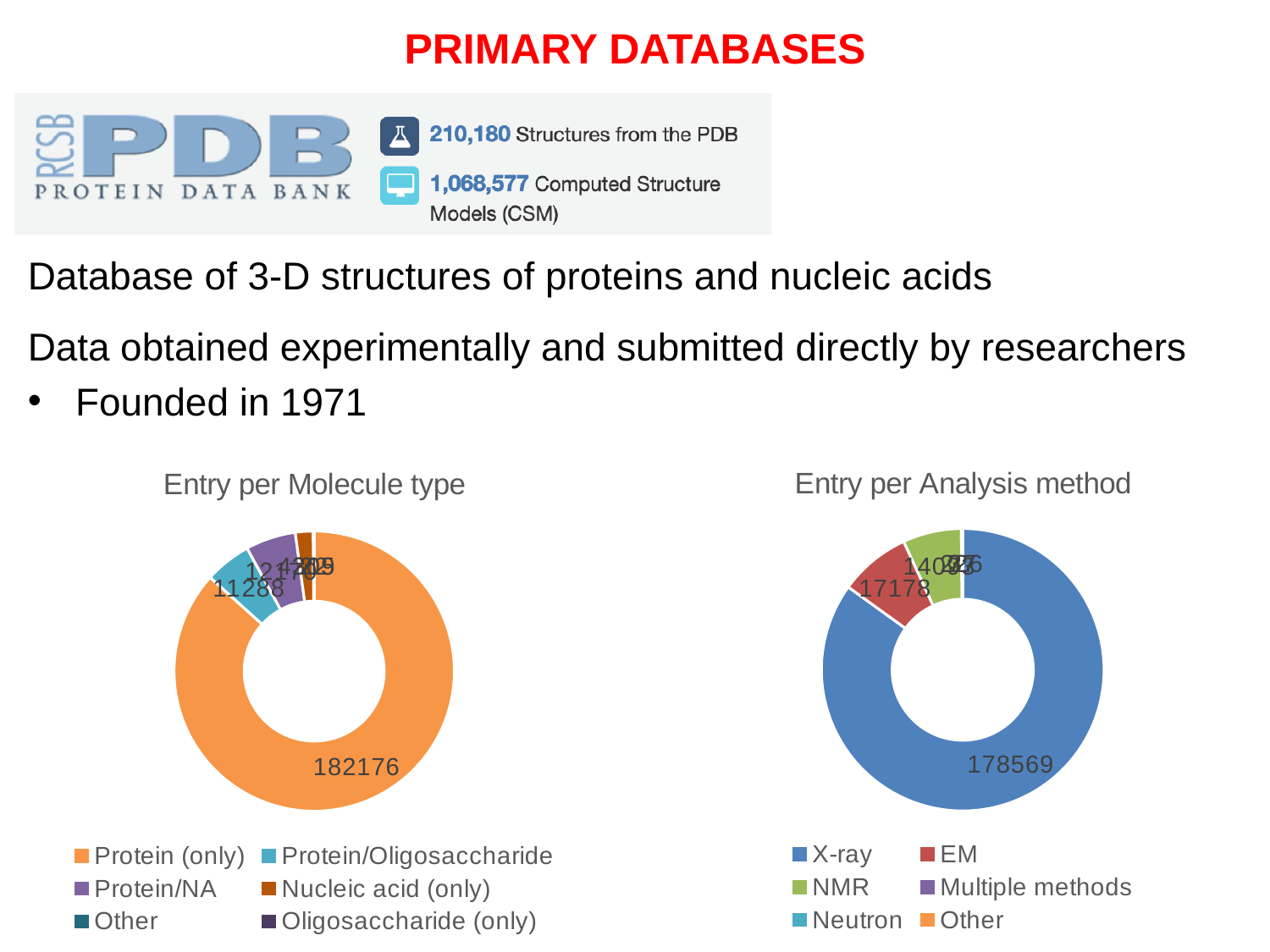
In the 'Entry per Molecule type' chart, what is the value for Protein/Oligosaccharide? 11288 In the 'Entry per Analysis method' chart, what is the difference between X-ray and EM? 161391 In the 'Entry per Analysis method' chart, what colour represents X-ray? Blue In the 'Entry per Analysis method' chart, what is the value for EM? 17178 In the 'Entry per Molecule type' chart, what is the difference between Protein (only) and Protein/Oligosaccharide? 170888 In the 'Entry per Molecule type' chart, which category has the largest share? Protein (only) In the 'Entry per Molecule type' chart, what is the value for Protein (only)? 182176 In the 'Entry per Analysis method' chart, which method has the largest share? X-ray In the 'Entry per Molecule type' chart, what kind of chart is shown? Doughnut (pie) chart In the 'Entry per Analysis method' chart, which is larger, EM or NMR? EM In the 'Entry per Analysis method' chart, what is the value for X-ray? 178569 In the 'Entry per Molecule type' chart, how many categories does the legend list? 6